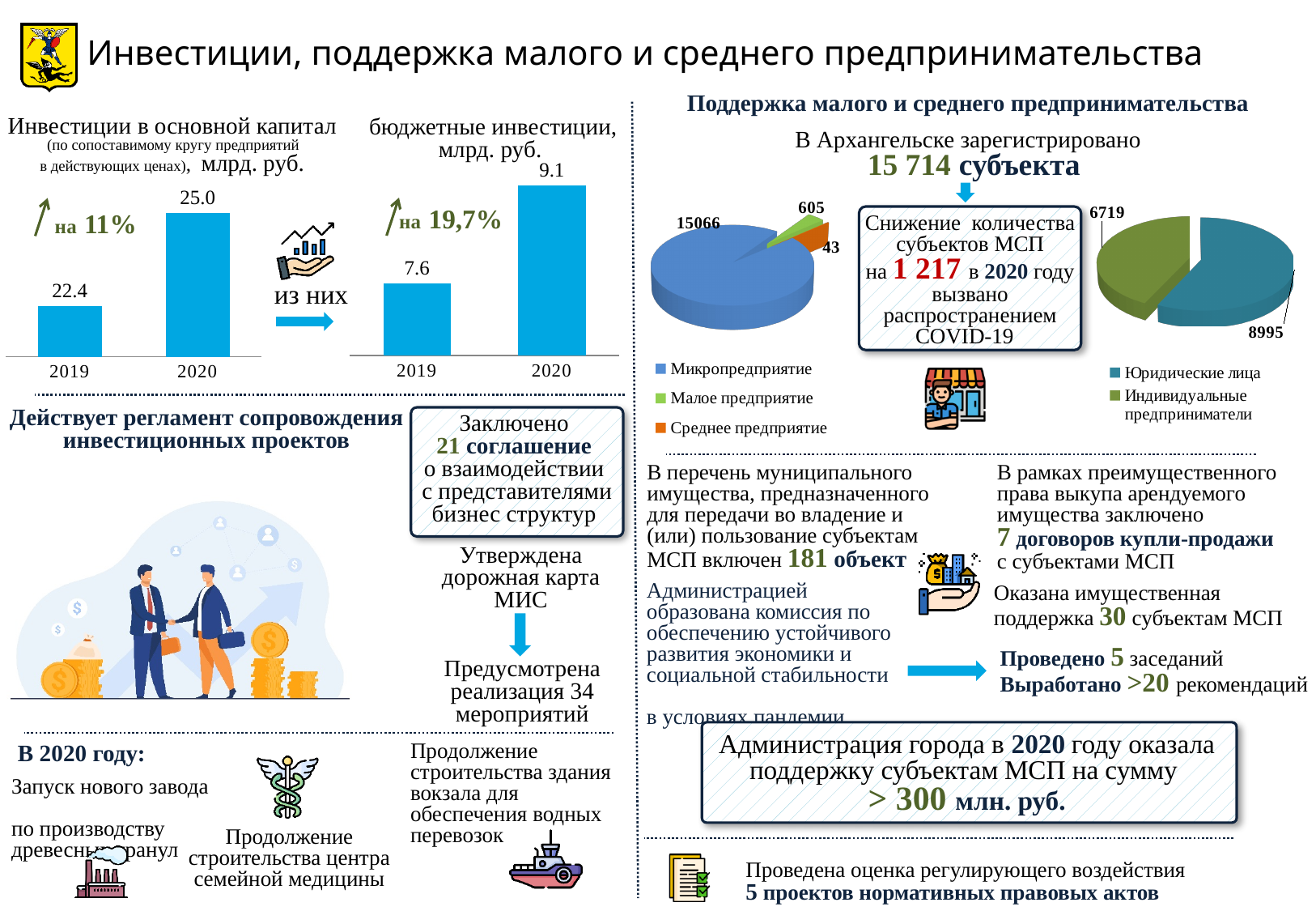
In the pie chart with the legend Микропредприятие / Малое предприятие / Среднее предприятие, which category has the smallest value? Среднее предприятие In the chart 'бюджетные инвестиции, млрд. руб.', what is the value for 2019? 7.6 How many categories does the legend of the pie chart on the left (Микропредприятие / Малое предприятие / Среднее предприятие) list? 3 In the chart 'Инвестиции в основной капитал', do the values rise or fall from 2019 to 2020? rise In the pie chart with the legend Микропредприятие / Малое предприятие / Среднее предприятие, what is the value for Малое предприятие? 605 In the pie chart with the legend Юридические лица / Индивидуальные предприниматели, what is the value for Юридические лица? 8995 In the pie chart with the legend Микропредприятие / Малое предприятие / Среднее предприятие, which category has the largest value? Микропредприятие What kind of chart is 'бюджетные инвестиции, млрд. руб.'? bar chart In the chart 'Инвестиции в основной капитал', what is the value for 2020? 25.0 In the pie chart with the legend Юридические лица / Индивидуальные предприниматели, which category is larger? Юридические лица In the chart 'бюджетные инвестиции, млрд. руб.', by how much does the 2020 value exceed the 2019 value? 1.5 In the chart 'Инвестиции в основной капитал', what is the difference between the 2020 and 2019 values? 2.6